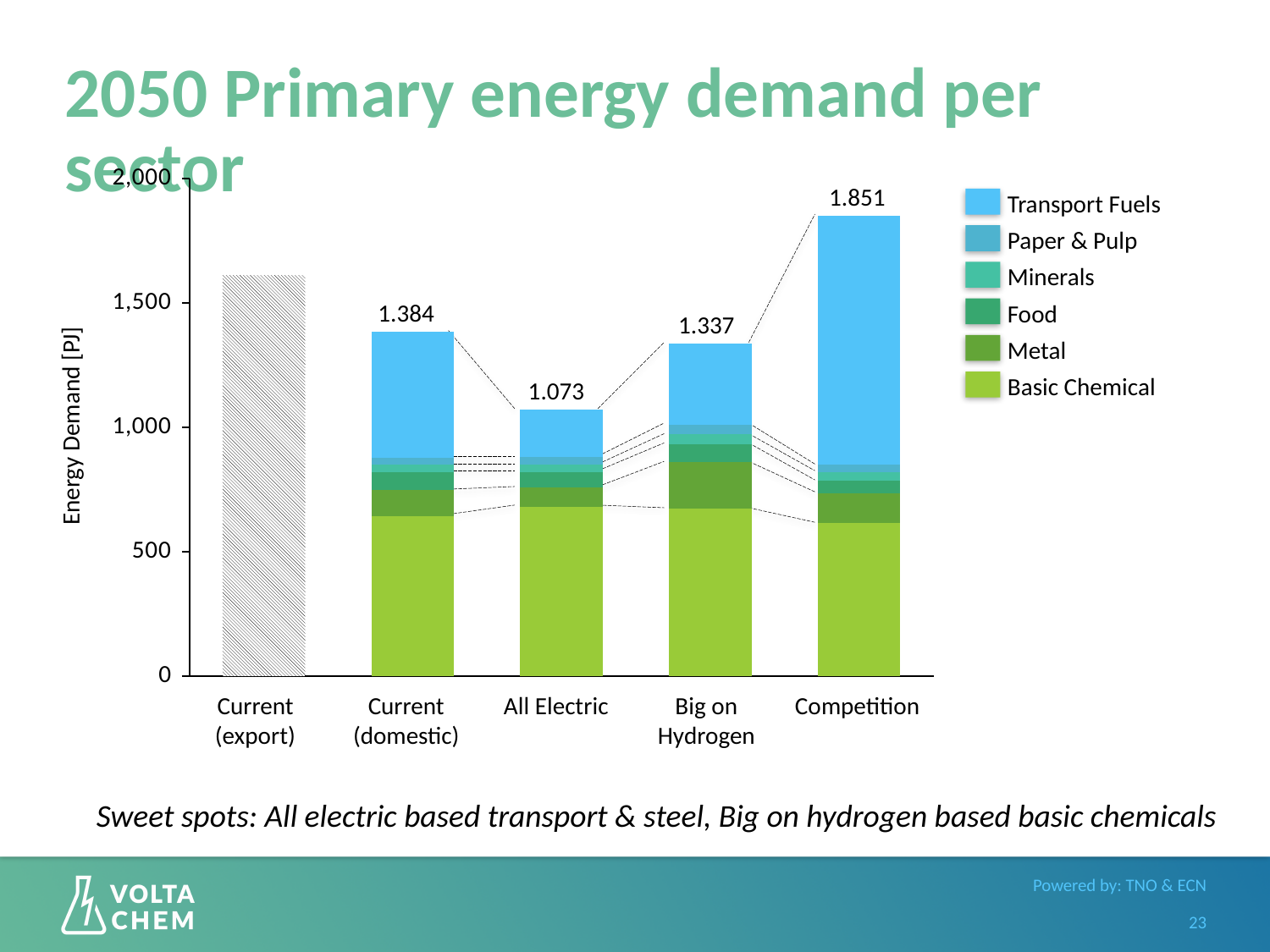
What is the total energy demand shown for Current (domestic)? 1.384 What is the total energy demand shown for the Competition scenario? 1.851 Which scenario has the highest total energy demand? Competition What kind of chart is shown on the slide? Stacked bar chart Which scenario has the lowest total energy demand? All Electric How many series does the legend list? 6 Which series is listed first (at the top) in the legend? Transport Fuels How many scenarios (bars) are shown on the x axis? 5 Which has the larger total energy demand, Current (domestic) or Big on Hydrogen? Current (domestic) Is the value for Current (export) greater or less than 1,500? greater What is the total energy demand shown for the All Electric scenario? 1.073 What is the label of the y axis? Energy Demand [PJ]